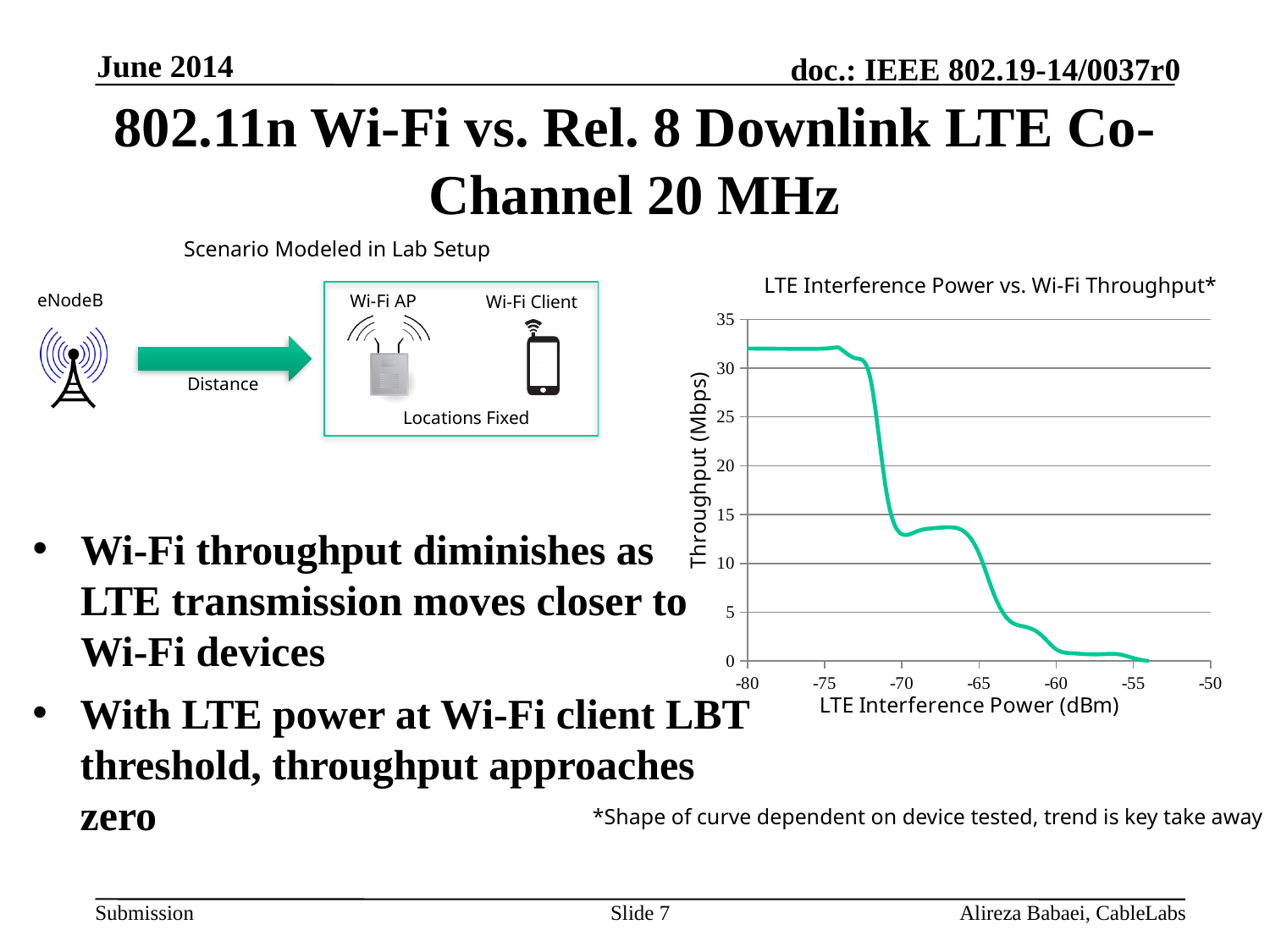
Is the throughput at -75 dBm greater or less than 30 Mbps? greater What is the label of the chart's x axis? LTE Interference Power (dBm) Is the throughput at -60 dBm greater or less than 5 Mbps? less What is the maximum value shown on the y axis of the chart? 35 What kind of chart is shown on the slide? line chart Is the throughput at -70 dBm greater or less than 20 Mbps? less Is the throughput higher at -75 dBm or at -65 dBm? -75 dBm Does the throughput rise or fall as LTE interference power increases along the x axis? fall What is the title of the chart? LTE Interference Power vs. Wi-Fi Throughput* How many lines are plotted on the chart? 1